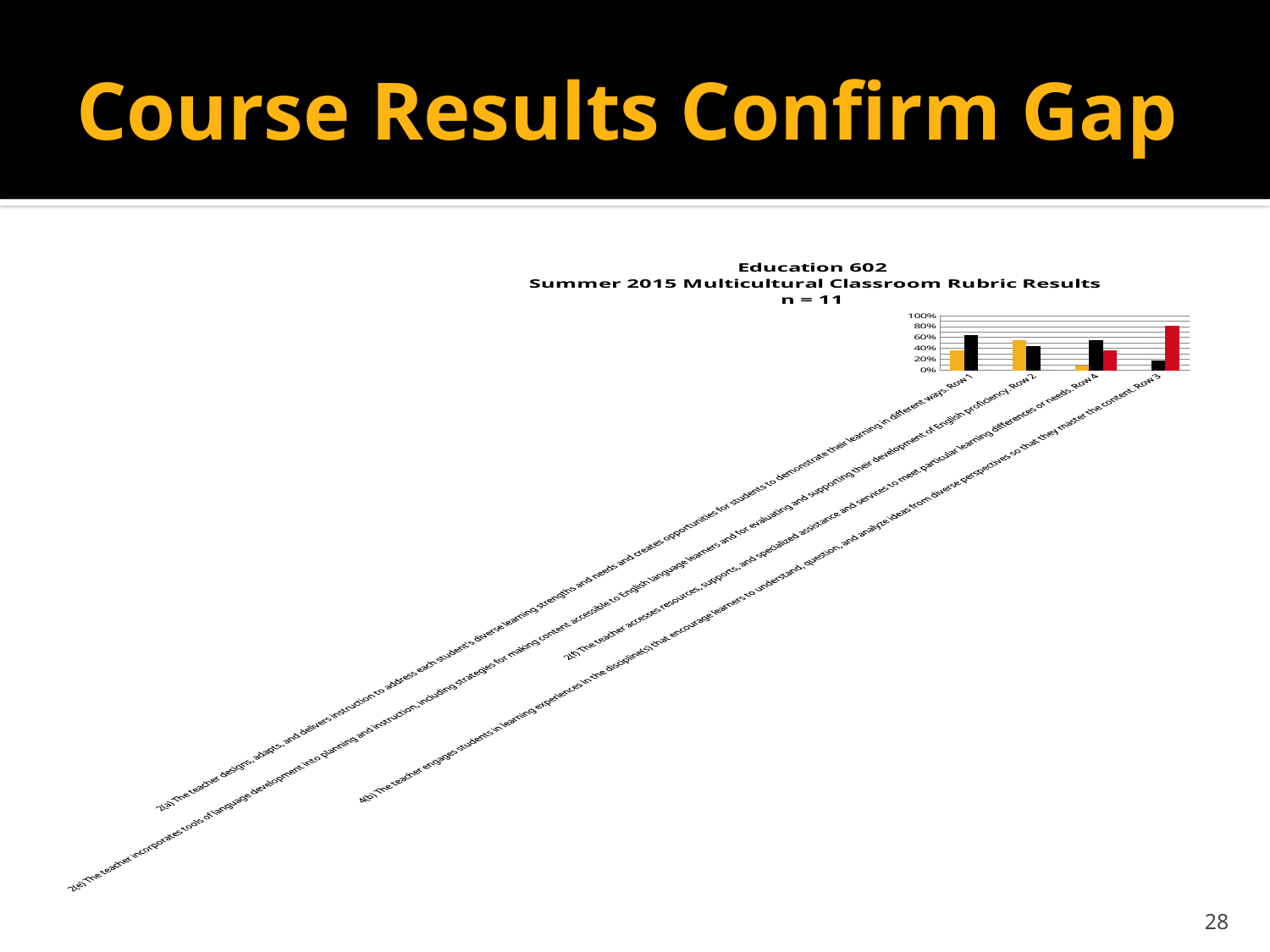
How many category groups are plotted along the x axis of the chart? 4 What sample size (n) is stated in the chart title? n = 11 Is the yellow bar in the third group (Row 4) greater or less than 20%? less In the first group (Row 1), which bar is taller, the yellow bar or the black bar? the black bar In the third group (Row 4), which bar is taller, the black bar or the red bar? the black bar Is the black bar in the last group (Row 3) greater or less than 40%? less Is the black bar in the first group (Row 1) greater or less than 40%? greater What is the title of the chart? Education 602 Summer 2015 Multicultural Classroom Rubric Results n = 11 Which bar is the tallest on the chart? the red bar in the last group (Row 3) What is the highest value shown on the chart's y axis? 100% What kind of chart is shown on the slide? bar chart